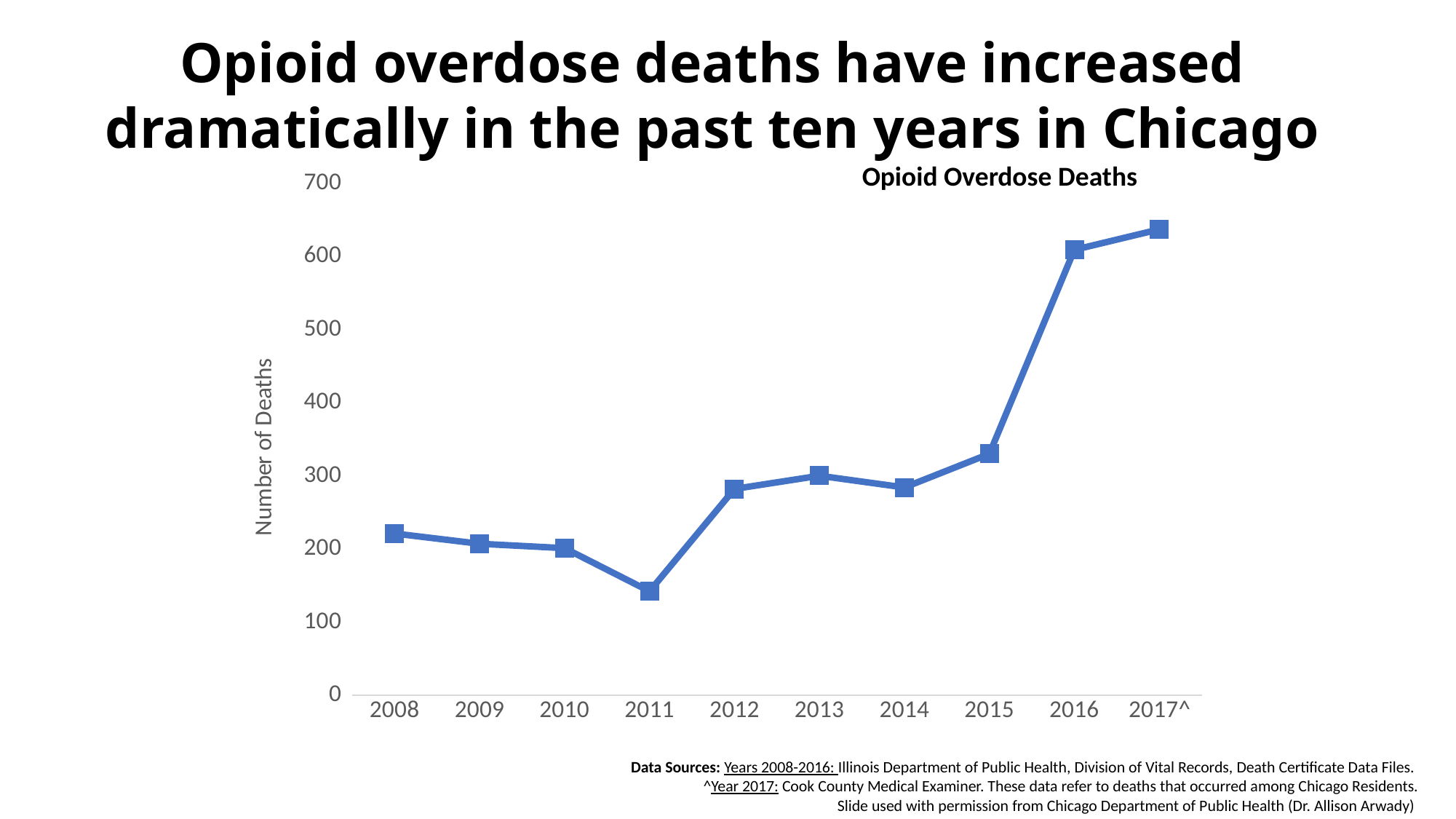
Do the values rise or fall from 2014 to 2017^? rise Which year has the highest number of opioid overdose deaths? 2017^ What is the label on the vertical axis? Number of Deaths Which year has the lowest number of opioid overdose deaths? 2011 Which year has more opioid overdose deaths, 2008 or 2011? 2008 Which year has more opioid overdose deaths, 2015 or 2016? 2016 Is the value for 2016 greater or less than 500? greater Is the value for 2017^ greater or less than 600? greater Is the value for 2011 greater or less than 200? less What kind of chart is shown on the slide? line chart How many years are plotted on the x axis? 10